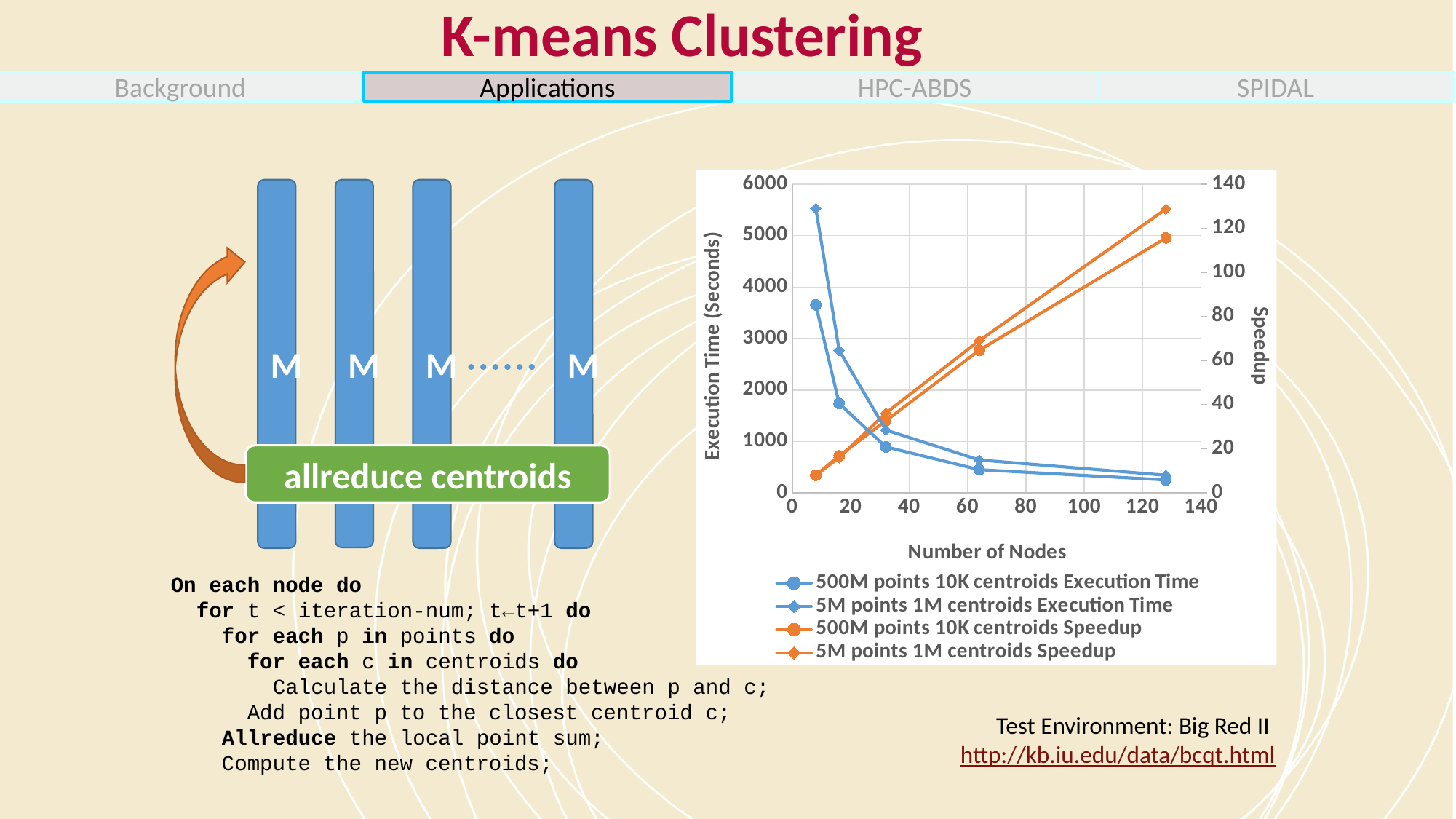
Is the 5M points 1M centroids Execution Time at 8 nodes greater or less than 5000 seconds? greater At 8 nodes, which series has the higher execution time: 500M points 10K centroids or 5M points 1M centroids? 5M points 1M centroids What is the label of the x axis of the chart? Number of Nodes Is the 500M points 10K centroids Speedup at 128 nodes greater or less than 100? greater Do the Execution Time series rise or fall as the number of nodes increases? Fall Is the 500M points 10K centroids Execution Time at 64 nodes greater or less than 1000 seconds? less Do the Speedup series rise or fall as the number of nodes increases? Rise How many data points are plotted for the 500M points 10K centroids Speedup series? 5 What kind of chart is shown on the slide? Line chart How many series does the chart legend list? 4